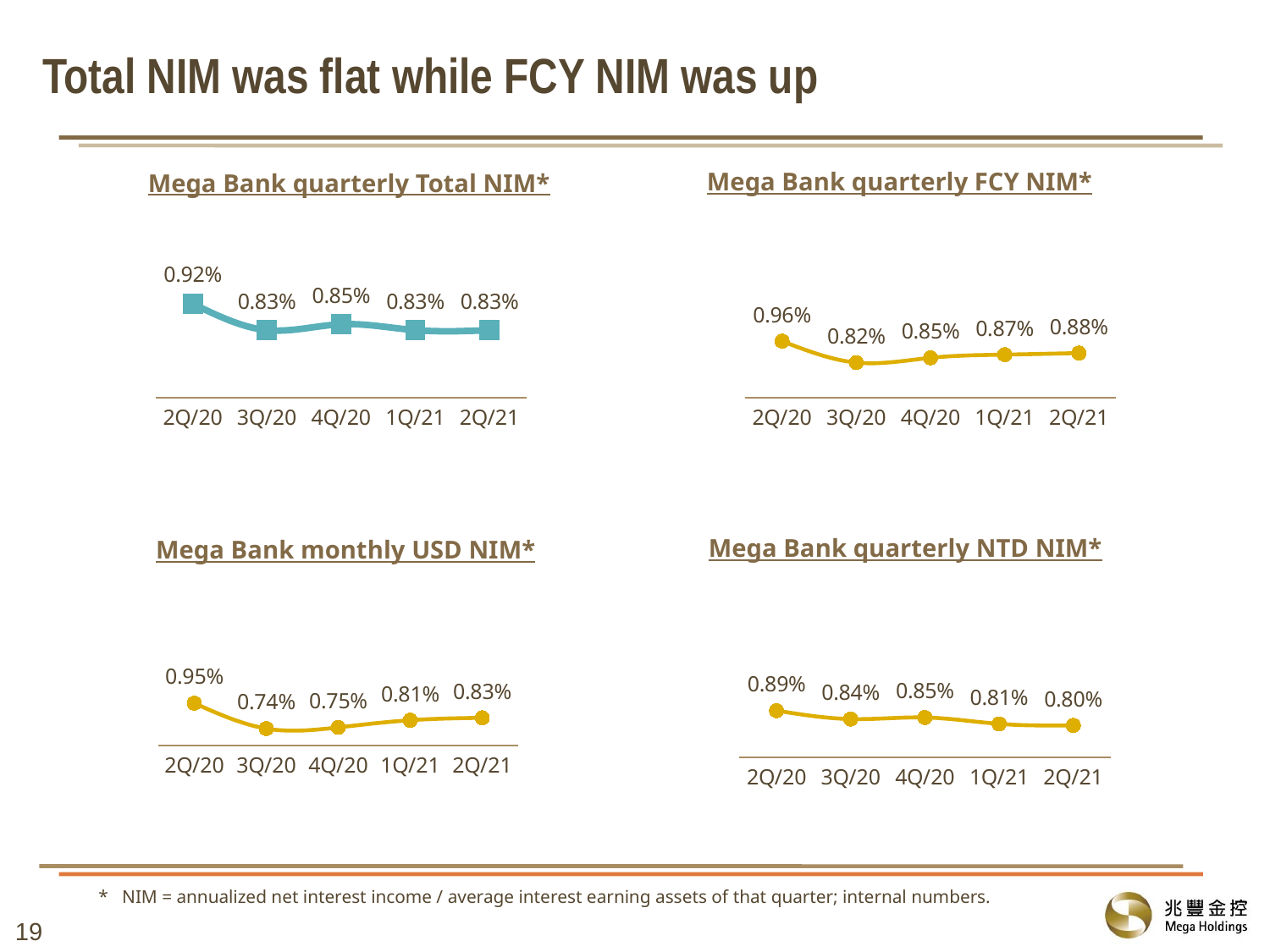
In the 'Mega Bank quarterly Total NIM*' chart, which is larger, the value for 4Q/20 or the value for 1Q/21? 4Q/20 In the 'Mega Bank quarterly NTD NIM*' chart, which quarter has the lowest value? 2Q/21 What kind of chart is the 'Mega Bank quarterly NTD NIM*' chart? Line chart In the 'Mega Bank monthly USD NIM*' chart, what is the difference between the 2Q/20 value and the 3Q/20 value? 0.21% In the 'Mega Bank quarterly FCY NIM*' chart, which quarter has the highest value? 2Q/20 How many charts are shown on the slide? 4 In the 'Mega Bank quarterly NTD NIM*' chart, what is the value for 1Q/21? 0.81% How many data points are plotted in the 'Mega Bank quarterly FCY NIM*' chart? 5 In the 'Mega Bank quarterly FCY NIM*' chart, what is the value for 2Q/21? 0.88% In the 'Mega Bank monthly USD NIM*' chart, what is the value for 3Q/20? 0.74% In the 'Mega Bank quarterly FCY NIM*' chart, do the values rise or fall from 3Q/20 to 2Q/21? Rise In the 'Mega Bank quarterly Total NIM*' chart, what is the value for 2Q/20? 0.92%